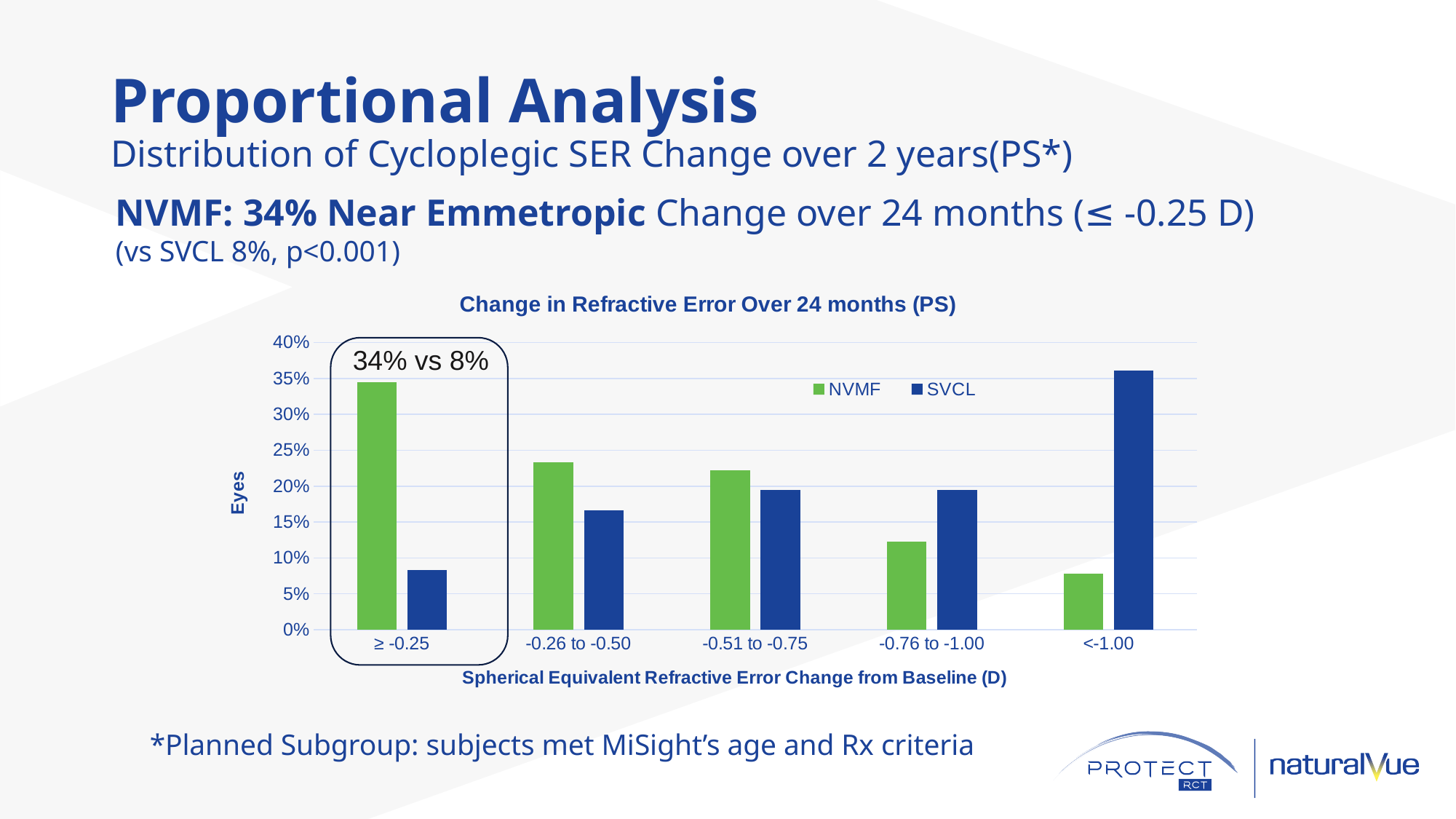
Do the NVMF values rise or fall moving from left to right along the x axis? Fall In the <-1.00 category, which series has the larger value, NVMF or SVCL? SVCL How many refractive error change categories are shown on the x axis? 5 Which category has the highest SVCL value? <-1.00 What is the NVMF value for the ≥ -0.25 category? 34% Is the NVMF value for the -0.26 to -0.50 category greater or less than 20%? greater What type of chart is shown on the slide? Bar chart How many series does the chart legend list? 2 What is the SVCL value for the ≥ -0.25 category? 8% What is the difference between the NVMF and SVCL values in the ≥ -0.25 category? 26 percentage points Which category has the highest NVMF value? ≥ -0.25 Which category has the lowest SVCL value? ≥ -0.25